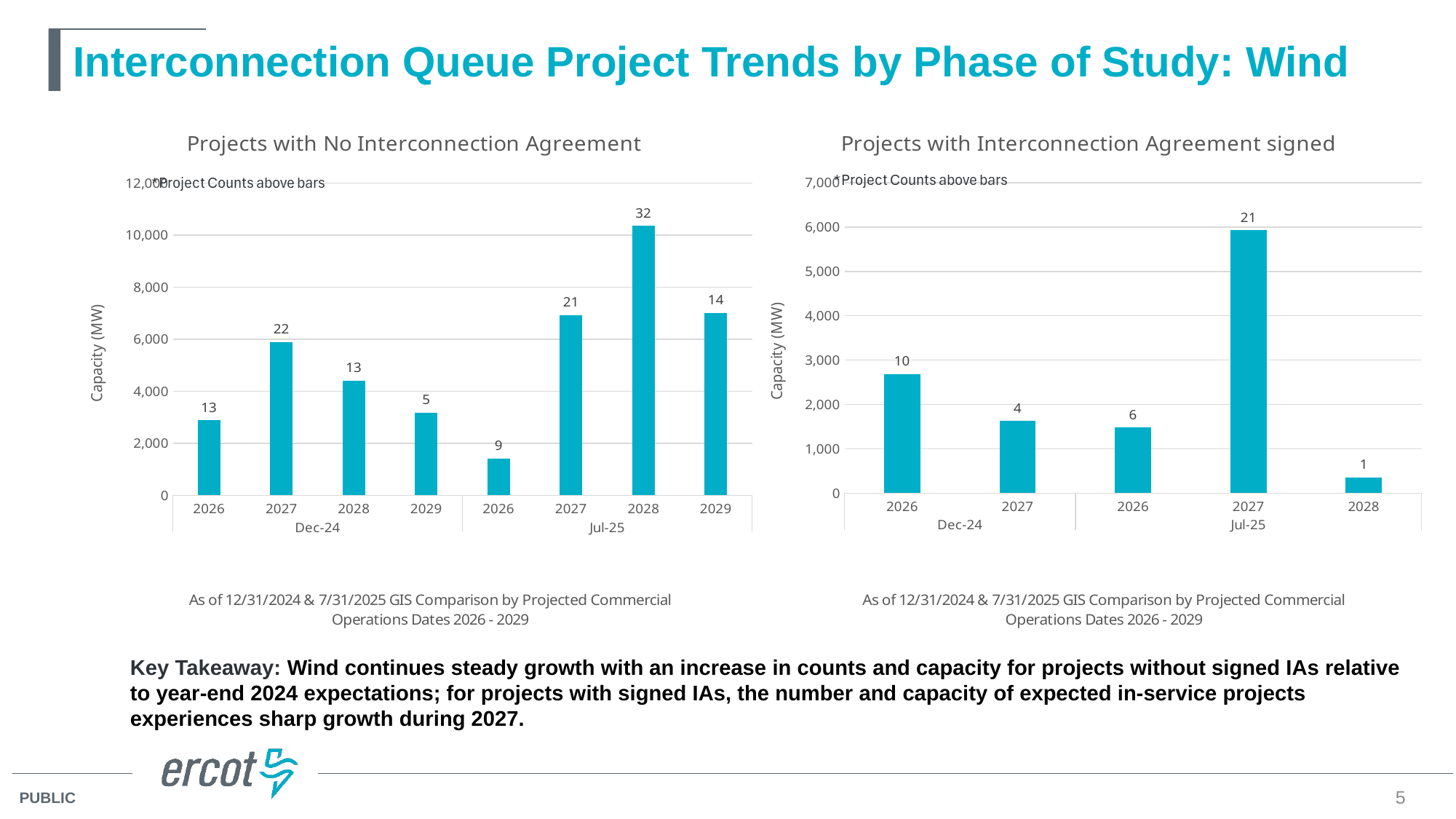
In the 'Projects with No Interconnection Agreement' chart, which bar has the lowest capacity? 2026 in the Jul-25 group In the 'Projects with Interconnection Agreement signed' chart, which bar has the highest capacity? 2027 in the Jul-25 group In the 'Projects with Interconnection Agreement signed' chart, what project count is shown above the 2027 bar in the Jul-25 group? 21 In the 'Projects with No Interconnection Agreement' chart, which has the larger capacity in the Dec-24 group: 2027 or 2028? 2027 In the 'Projects with No Interconnection Agreement' chart, what project count is shown above the 2028 bar in the Jul-25 group? 32 In the 'Projects with No Interconnection Agreement' chart, which bar has the highest capacity? 2028 in the Jul-25 group In the 'Projects with No Interconnection Agreement' chart, is the capacity for 2028 in the Jul-25 group greater or less than 10,000? greater In the 'Projects with Interconnection Agreement signed' chart, is the capacity for 2026 in the Dec-24 group greater or less than 2,000? greater In the 'Projects with No Interconnection Agreement' chart, how many bars are plotted? 8 In the 'Projects with Interconnection Agreement signed' chart, how many bars are plotted? 5 In the 'Projects with Interconnection Agreement signed' chart, which bar has the lowest capacity? 2028 in the Jul-25 group In the 'Projects with No Interconnection Agreement' chart, what is the difference between the project count for 2028 in the Jul-25 group and the project count for 2027 in the Dec-24 group? 10